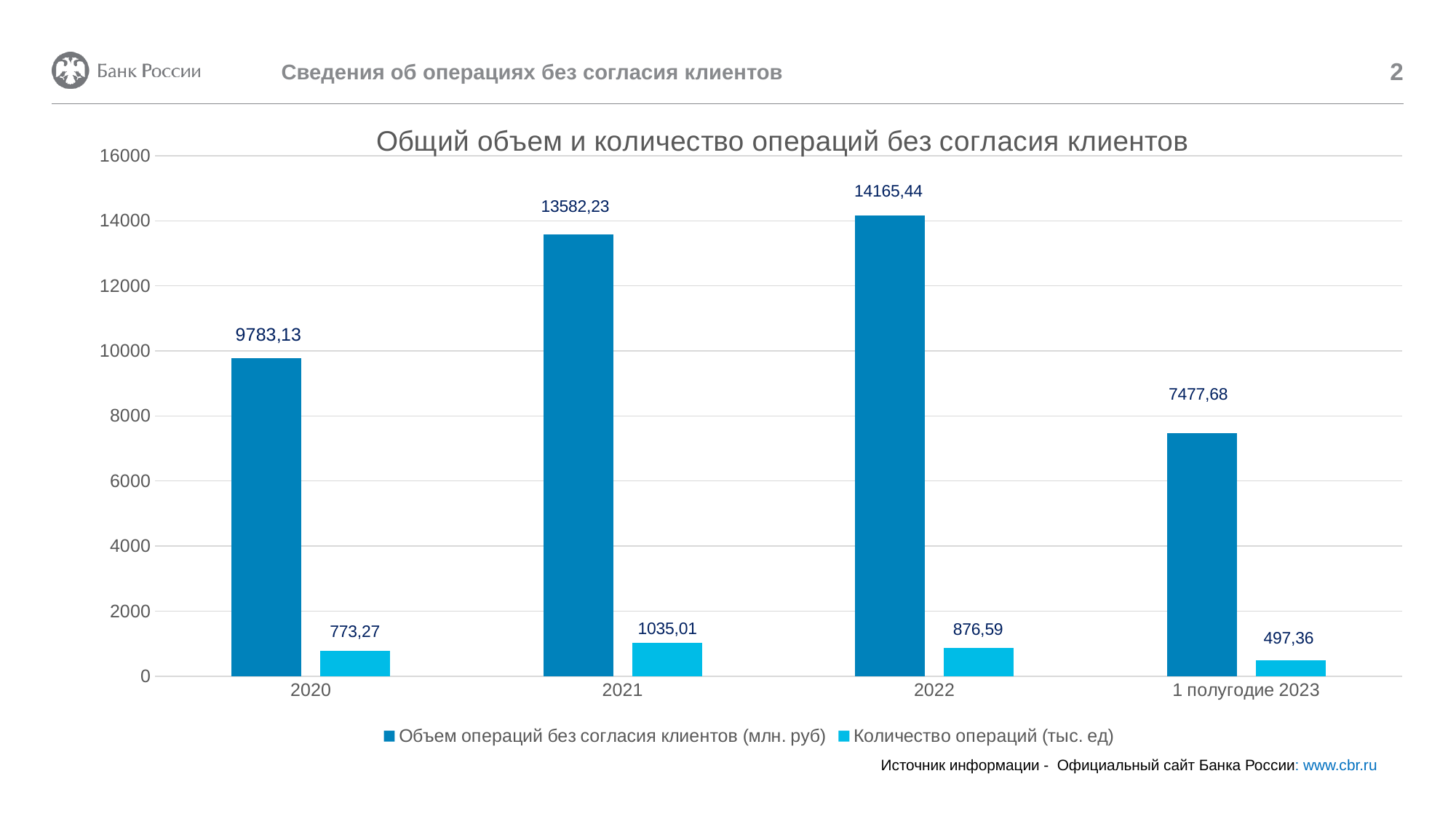
How many categories are shown on the x axis? 4 What is the difference between the "Количество операций (тыс. ед)" values for 2021 and 2020? 261,74 Which category has the highest value for "Объем операций без согласия клиентов (млн. руб)"? 2022 How many series does the legend list? 2 What is the value of "Количество операций (тыс. ед)" for 1 полугодие 2023? 497,36 What is the difference between the "Объем операций без согласия клиентов (млн. руб)" values for 2022 and 2021? 583,21 What is the value of "Количество операций (тыс. ед)" for 2020? 773,27 What kind of chart is shown on the slide? bar chart What is the value of "Объем операций без согласия клиентов (млн. руб)" for 2021? 13582,23 Which category has the lowest value for "Количество операций (тыс. ед)"? 1 полугодие 2023 Which is larger: the "Количество операций (тыс. ед)" value for 2021 or for 2022? 2021 Is the value of "Объем операций без согласия клиентов (млн. руб)" for 1 полугодие 2023 greater or less than 8000? less